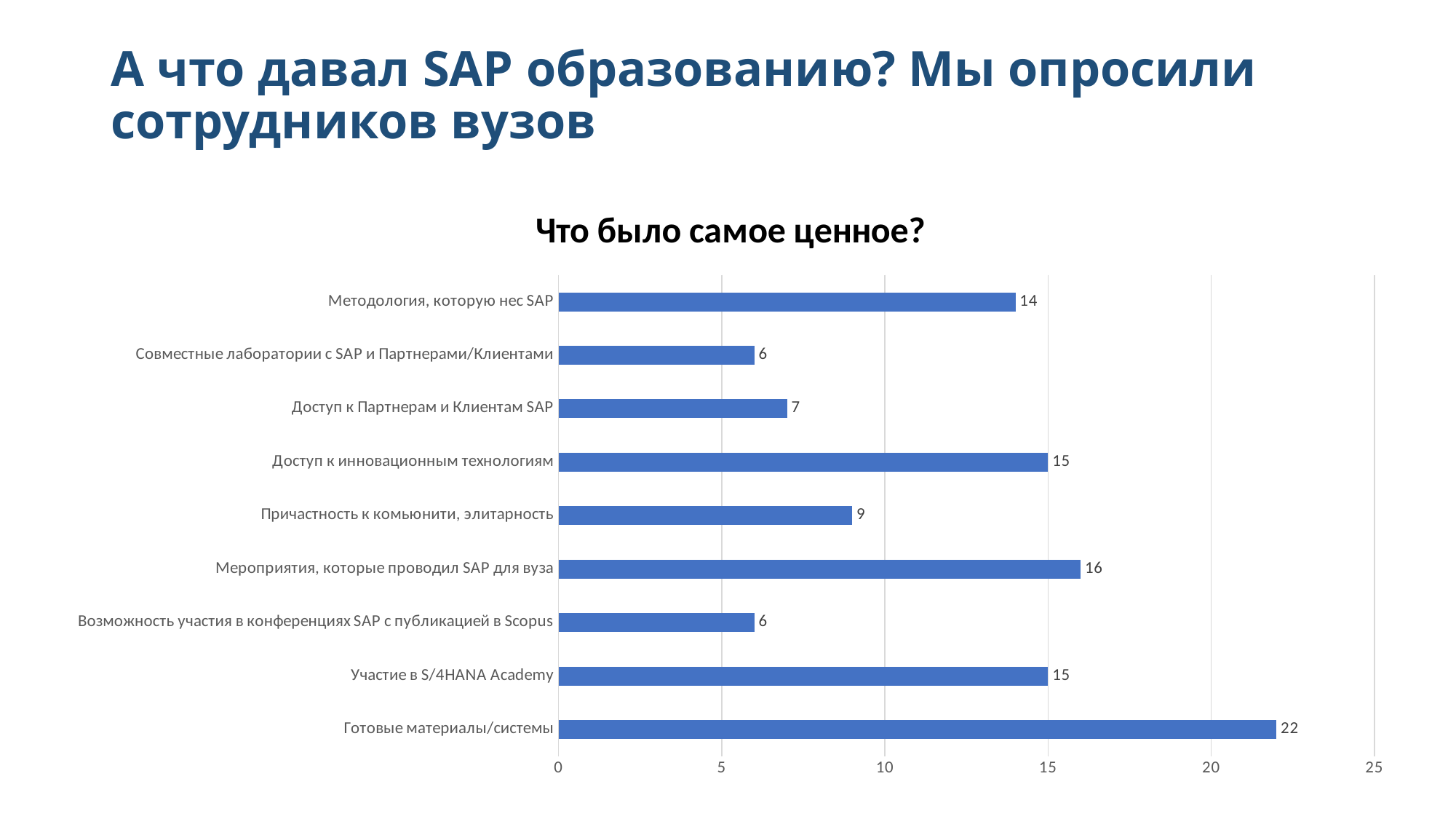
What is the value for "Участие в S/4HANA Academy"? 15 What is the difference between "Готовые материалы/системы" and "Мероприятия, которые проводил SAP для вуза"? 6 What is the value for "Готовые материалы/системы"? 22 How many categories are shown in the chart? 9 What is the title of the chart? Что было самое ценное? Is the value for "Мероприятия, которые проводил SAP для вуза" greater or less than 10? greater What is the value for "Методология, которую нес SAP"? 14 What is the difference between "Доступ к инновационным технологиям" and "Совместные лаборатории с SAP и Партнерами/Клиентами"? 9 What kind of chart is shown on the slide? bar chart Which category has the highest value? Готовые материалы/системы Which is larger: "Доступ к Партнерам и Клиентам SAP" or "Причастность к комьюнити, элитарность"? Причастность к комьюнити, элитарность What is the value for "Причастность к комьюнити, элитарность"? 9